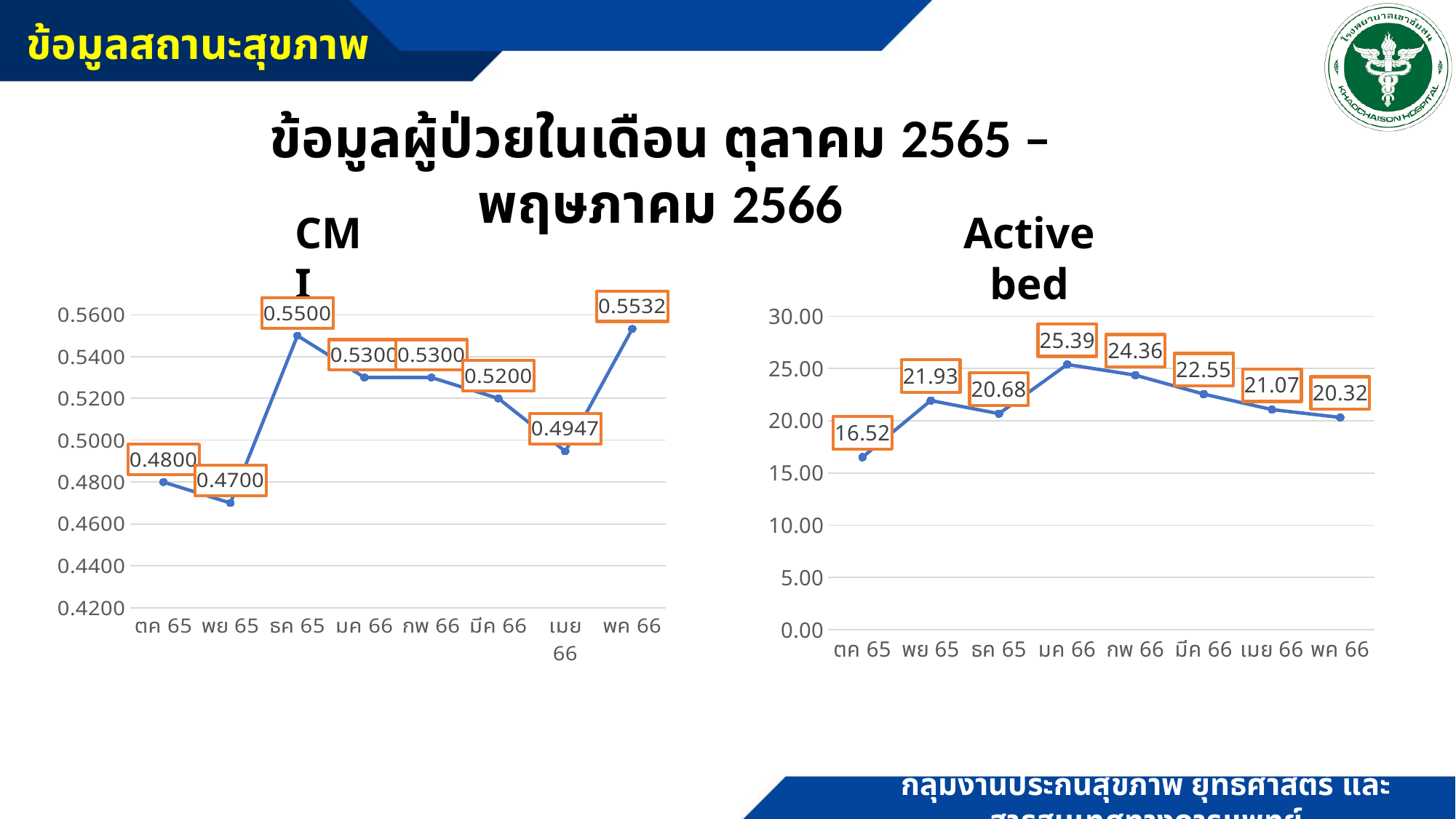
In the CMI chart, which month has the highest value? พค 66 In the CMI chart, how many months are plotted? 8 In the CMI chart, which month has the lowest value? พย 65 In the Active bed chart, which month has the lowest value? ตค 65 In the Active bed chart, which is larger, the value for พย 65 or ธค 65? พย 65 In the Active bed chart, is the value for ตค 65 greater or less than 20.00? less What type of chart is the CMI chart? Line chart In the CMI chart, what is the difference between the values for พค 66 and เมย 66? 0.0585 In the Active bed chart, what is the difference between the values for มค 66 and ตค 65? 8.87 In the CMI chart, what is the value for ธค 65? 0.5500 In the Active bed chart, do the values rise or fall from มค 66 to พค 66? Fall In the Active bed chart, what is the value for มค 66? 25.39